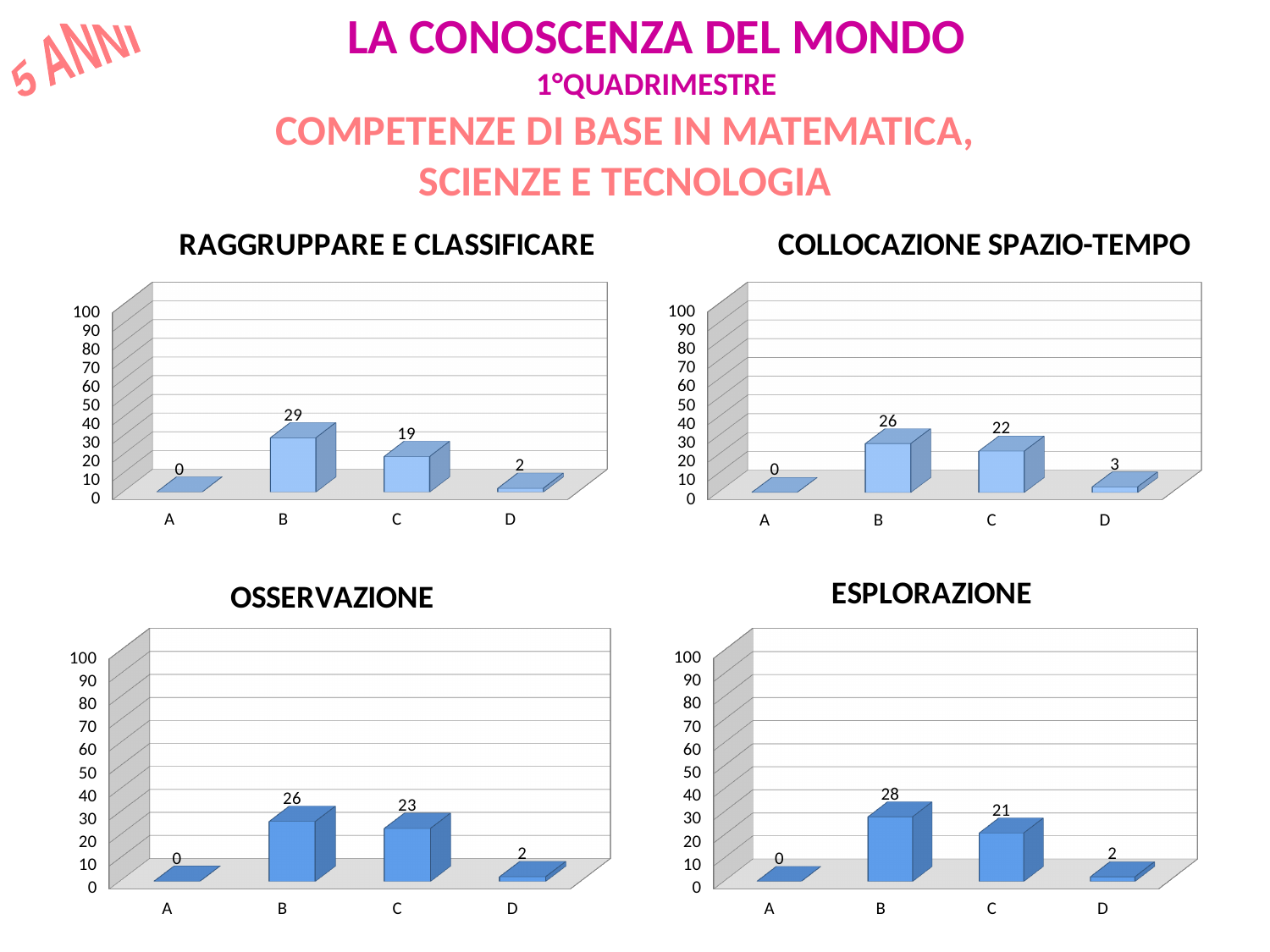
In the RAGGRUPPARE E CLASSIFICARE chart, is the value for C greater or less than 50? less How many categories are shown in the ESPLORAZIONE chart? 4 In the COLLOCAZIONE SPAZIO-TEMPO chart, what is the difference between the values for B and C? 4 In the RAGGRUPPARE E CLASSIFICARE chart, what is the value for B? 29 In the OSSERVAZIONE chart, what is the value for C? 23 In the OSSERVAZIONE chart, which is larger, the value for B or the value for C? B In the ESPLORAZIONE chart, what is the difference between the values for B and D? 26 In the COLLOCAZIONE SPAZIO-TEMPO chart, what is the value for D? 3 How many charts are shown on the slide? 4 In the ESPLORAZIONE chart, which category has the highest value? B What kind of chart is the OSSERVAZIONE chart? bar chart In the RAGGRUPPARE E CLASSIFICARE chart, which category has the lowest value? A